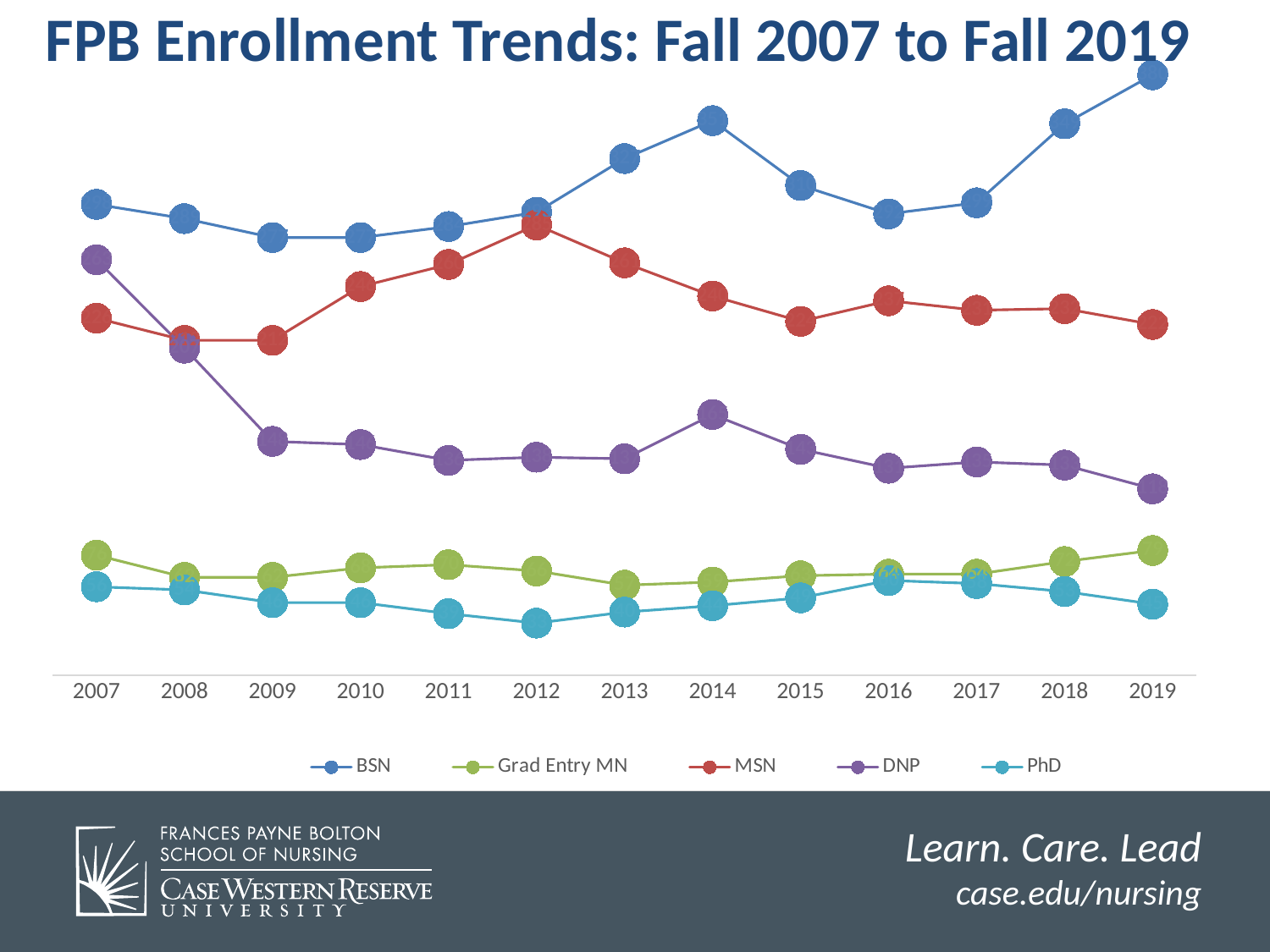
How many years are plotted along the x axis? 13 Does the DNP series rise or fall from 2007 to 2009? fall In 2014, which is higher, BSN or MSN? BSN In which year is the MSN series at its highest? 2012 In which year is the PhD series at its lowest? 2012 Which series has the highest value in 2019? BSN Which series has the lowest value in 2019? PhD In 2007, which is higher, DNP or MSN? DNP Does the BSN series rise or fall from 2016 to 2019? rise What is the title of the chart? FPB Enrollment Trends: Fall 2007 to Fall 2019 What kind of chart is shown on the slide? line chart How many series does the legend list? 5